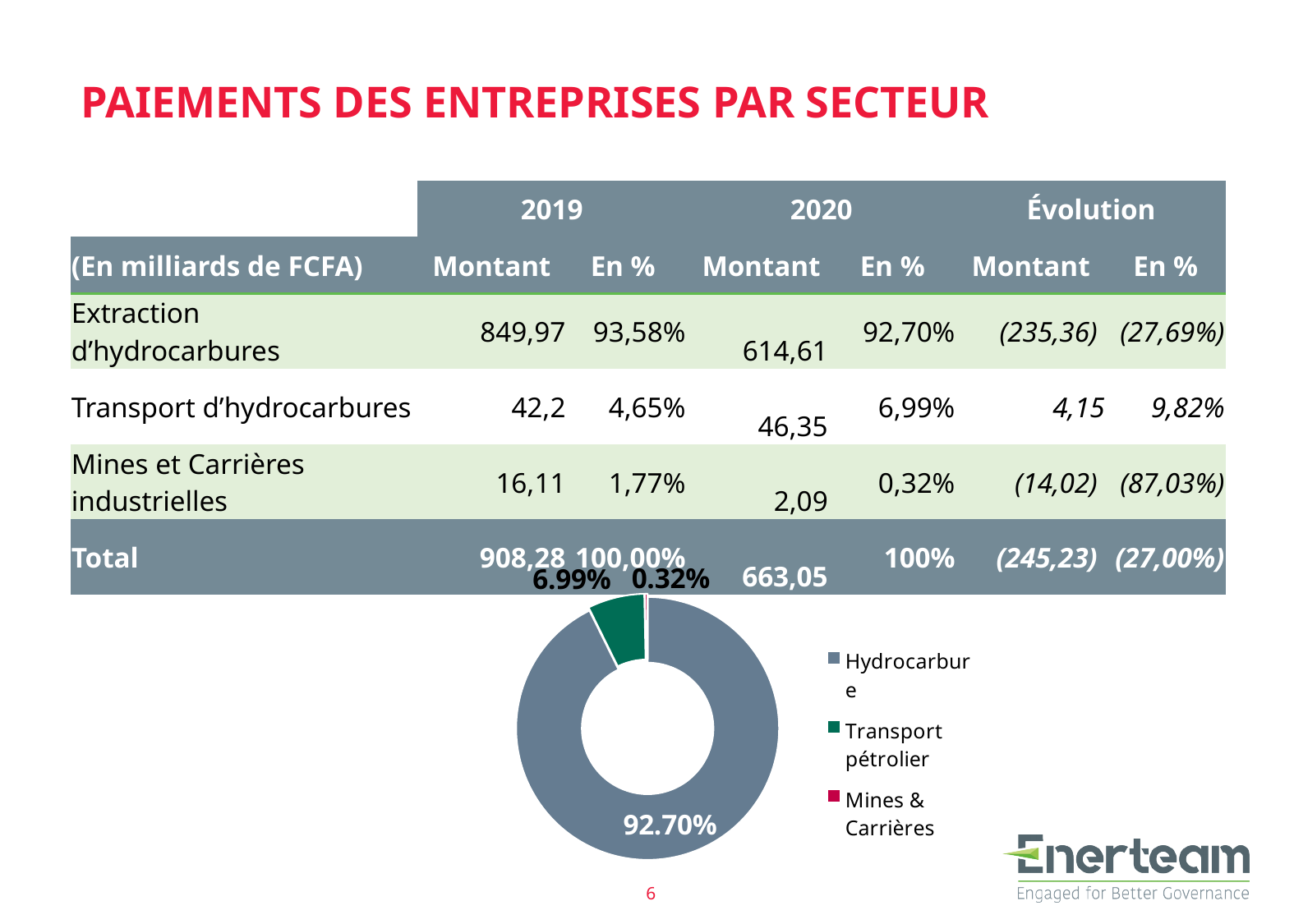
What is the difference between the Hydrocarbure share and the Transport pétrolier share in the doughnut chart? 85.71% What kind of chart is shown on the slide? Doughnut chart What is the value shown for Mines & Carrières in the doughnut chart? 0.32% What is the value shown for Hydrocarbure in the doughnut chart? 92.70% What is the value shown for Transport pétrolier in the doughnut chart? 6.99% Which category has the smallest share in the doughnut chart? Mines & Carrières How many categories does the doughnut chart show? 3 Which category has the largest share in the doughnut chart? Hydrocarbure Which is larger in the doughnut chart, Transport pétrolier or Mines & Carrières? Transport pétrolier What is the difference between the Transport pétrolier share and the Mines & Carrières share in the doughnut chart? 6.67% What colour is the Transport pétrolier slice in the doughnut chart? Green How many entries does the legend of the doughnut chart list? 3